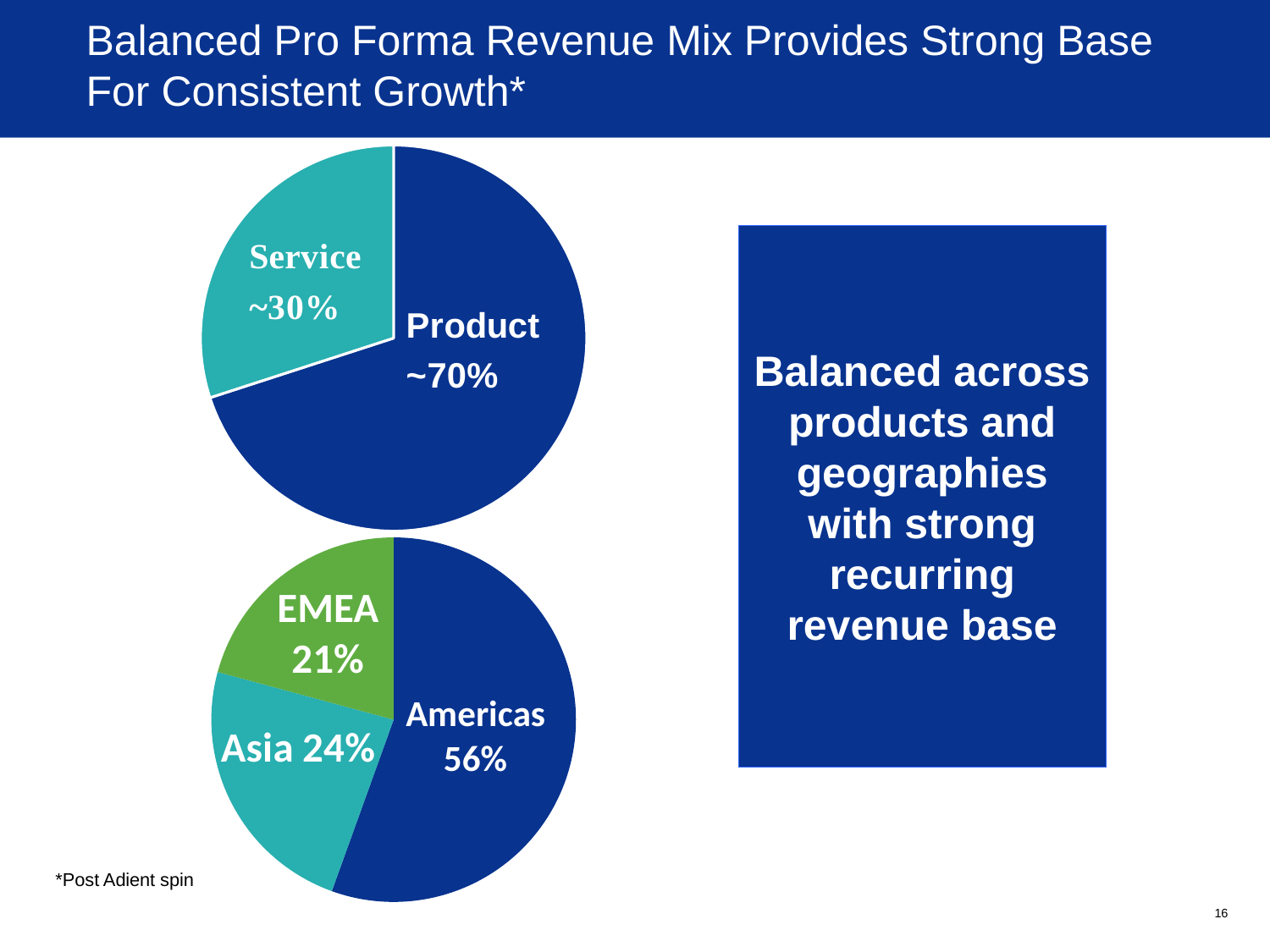
In the bottom pie chart, what is the difference between the Asia share and the EMEA share? 3% In the bottom pie chart, what colour is the EMEA slice? Green In the bottom pie chart, what share of revenue comes from the Americas? 56% In the bottom pie chart, what is the value for Asia? 24% In the bottom pie chart, what is the value for EMEA? 21% In the bottom pie chart, which region has the smallest share? EMEA In the bottom pie chart, which region has the largest share? Americas In the bottom pie chart, how many regions are shown? 3 In the top pie chart, which segment is larger, Product or Service? Product In the top pie chart, how many segments are shown? 2 In the bottom pie chart, what is the difference between the Americas share and the Asia share? 32% What type of chart is the top chart on the slide? Pie chart